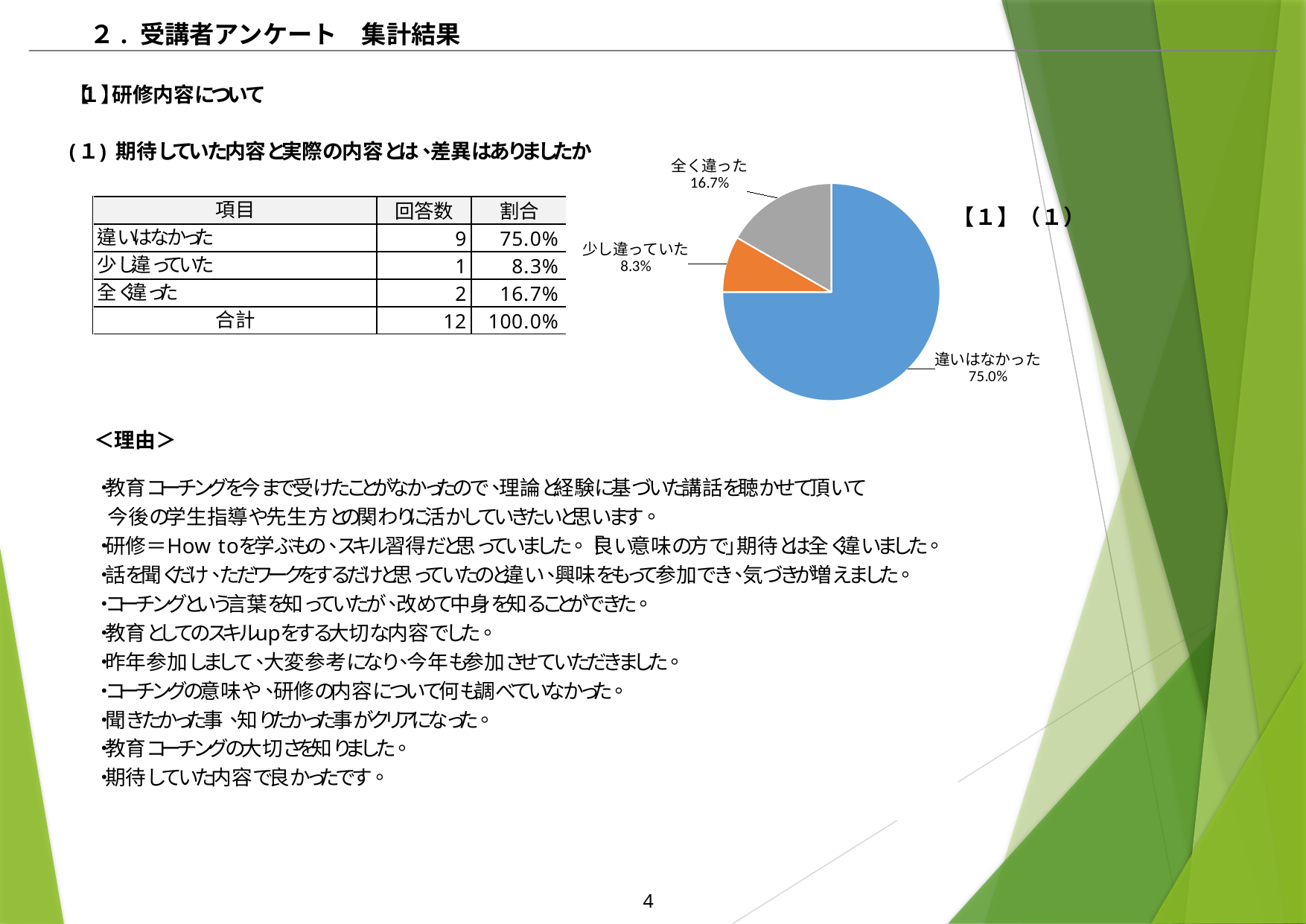
What is the difference in percentage points between the 違いはなかった slice and the 全く違った slice? 58.3 What share of the pie does 少し違っていた represent? 8.3% What share of the pie does 全く違った represent? 16.7% Which category has the largest slice of the pie? 違いはなかった How many slices does the pie chart have? 3 What kind of chart is shown on the slide? pie chart What is the difference in percentage points between the 全く違った slice and the 少し違っていた slice? 8.4 What share of the pie does 違いはなかった represent? 75.0% What colour is the slice for 違いはなかった? blue Which category has the smallest slice of the pie? 少し違っていた Which is larger, the slice for 全く違った or the slice for 少し違っていた? 全く違った What colour is the slice for 少し違っていた? orange